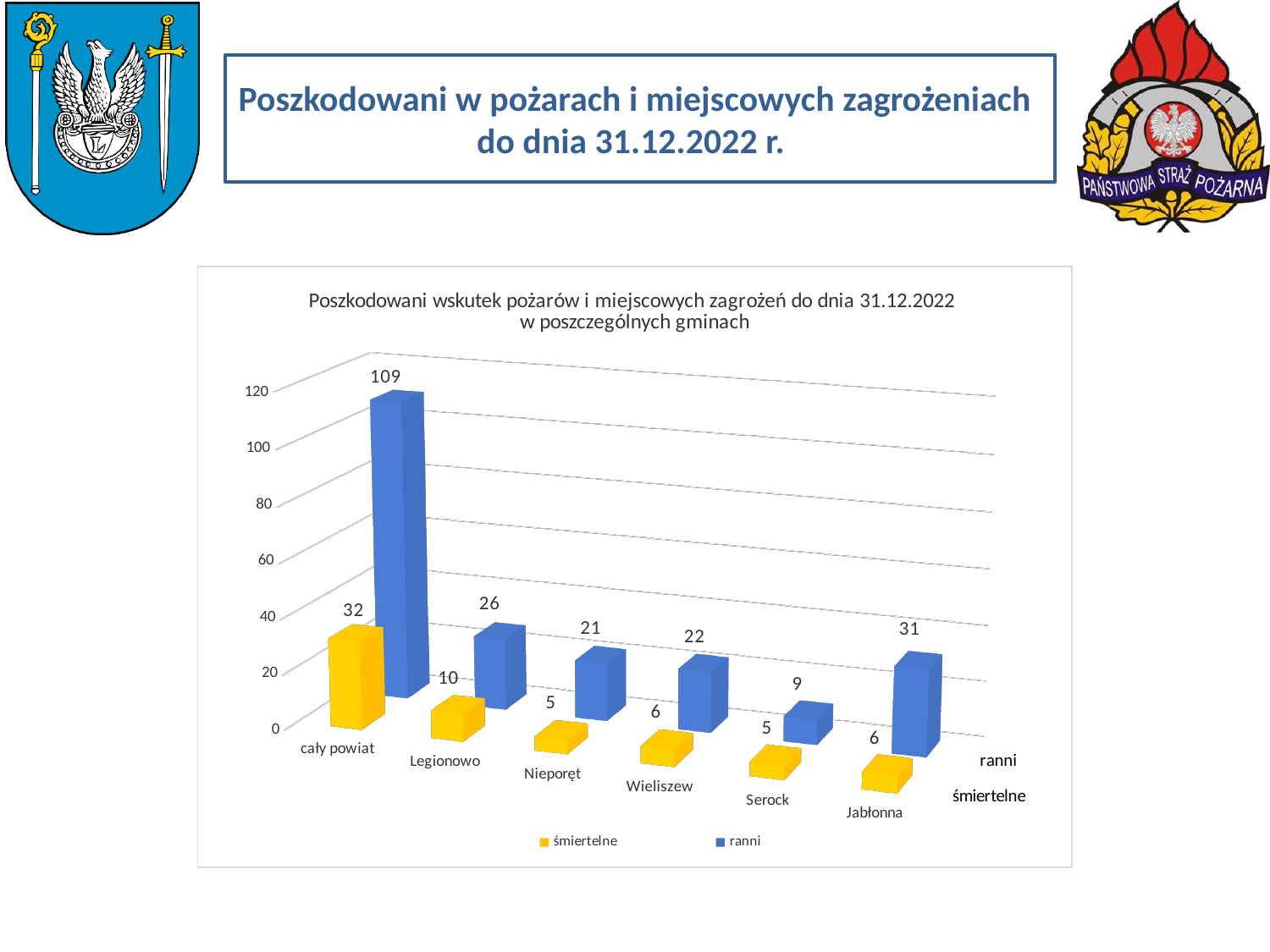
Excluding cały powiat, which gmina has the highest value of ranni? Jabłonna What kind of chart is shown on the slide? bar chart Which is larger: ranni for Legionowo or ranni for Wieliszew? ranni for Legionowo How many series does the legend list? 2 Which category has the lowest value of ranni? Serock What is the value of ranni for cały powiat? 109 How many categories are shown on the x axis of the chart? 6 What is the value of śmiertelne for Legionowo? 10 What is the value of ranni for Jabłonna? 31 What is the difference between ranni and śmiertelne for cały powiat? 77 What is the value of śmiertelne for Wieliszew? 6 What colour are the bars for the śmiertelne series? yellow